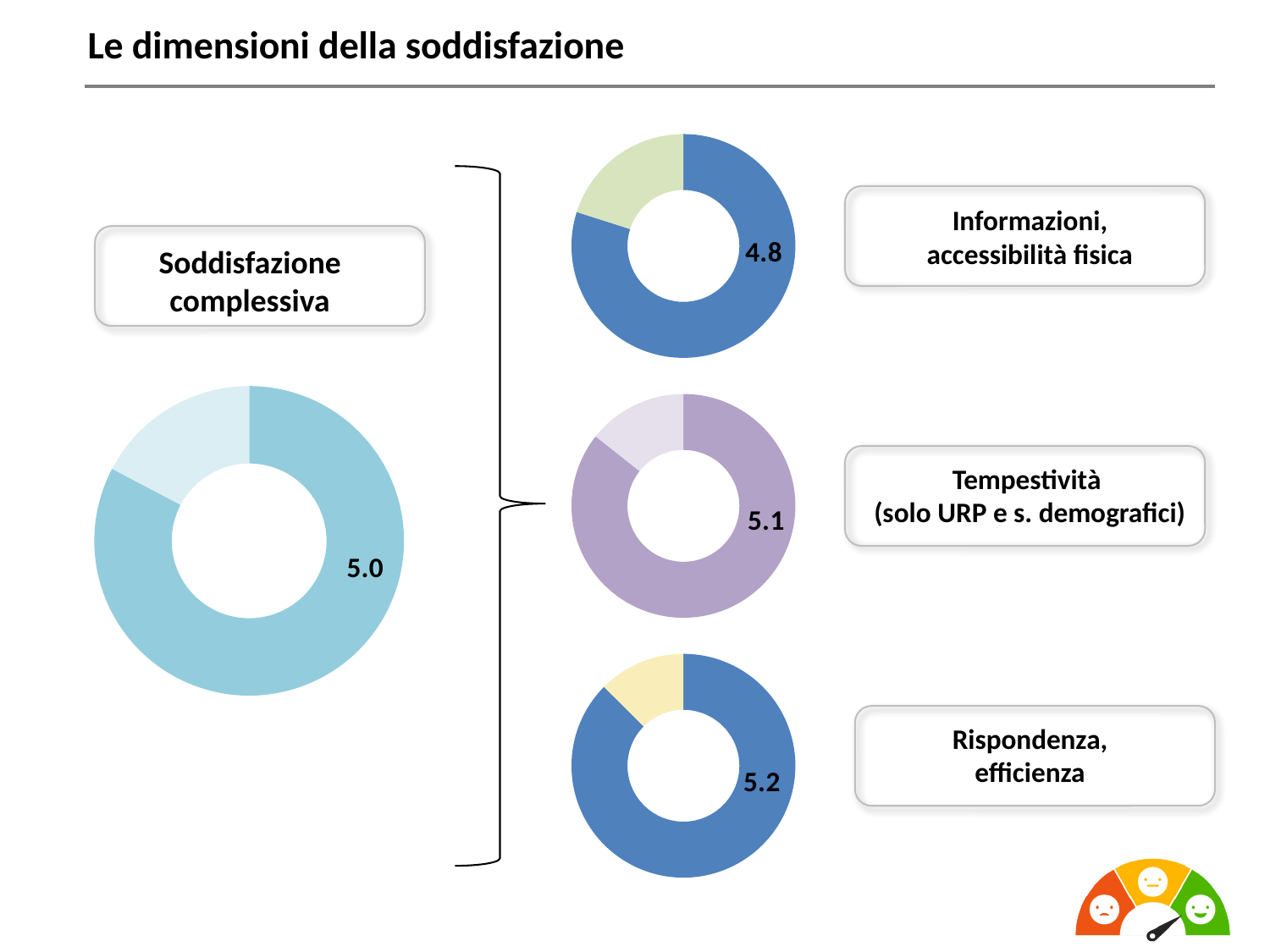
What value is shown on the donut chart next to "Informazioni, accessibilità fisica"? 4.8 Is the value for "Soddisfazione complessiva" greater or less than the value for "Rispondenza, efficienza"? less What is the title of the slide containing the donut charts? Le dimensioni della soddisfazione What value is shown on the donut chart next to "Tempestività (solo URP e s. demografici)"? 5.1 What kind of chart is used for "Soddisfazione complessiva"? Donut chart What value is shown on the large donut chart labelled "Soddisfazione complessiva"? 5.0 Which of the three dimension charts on the right shows the highest value? Rispondenza, efficienza Which of the three dimension charts on the right shows the lowest value? Informazioni, accessibilità fisica How many donut charts are on the slide? 4 What value is shown on the donut chart next to "Rispondenza, efficienza"? 5.2 What is the difference between the value for "Rispondenza, efficienza" and the value for "Informazioni, accessibilità fisica"? 0.4 Which is larger: the value for "Tempestività" or the value for "Informazioni, accessibilità fisica"? Tempestività